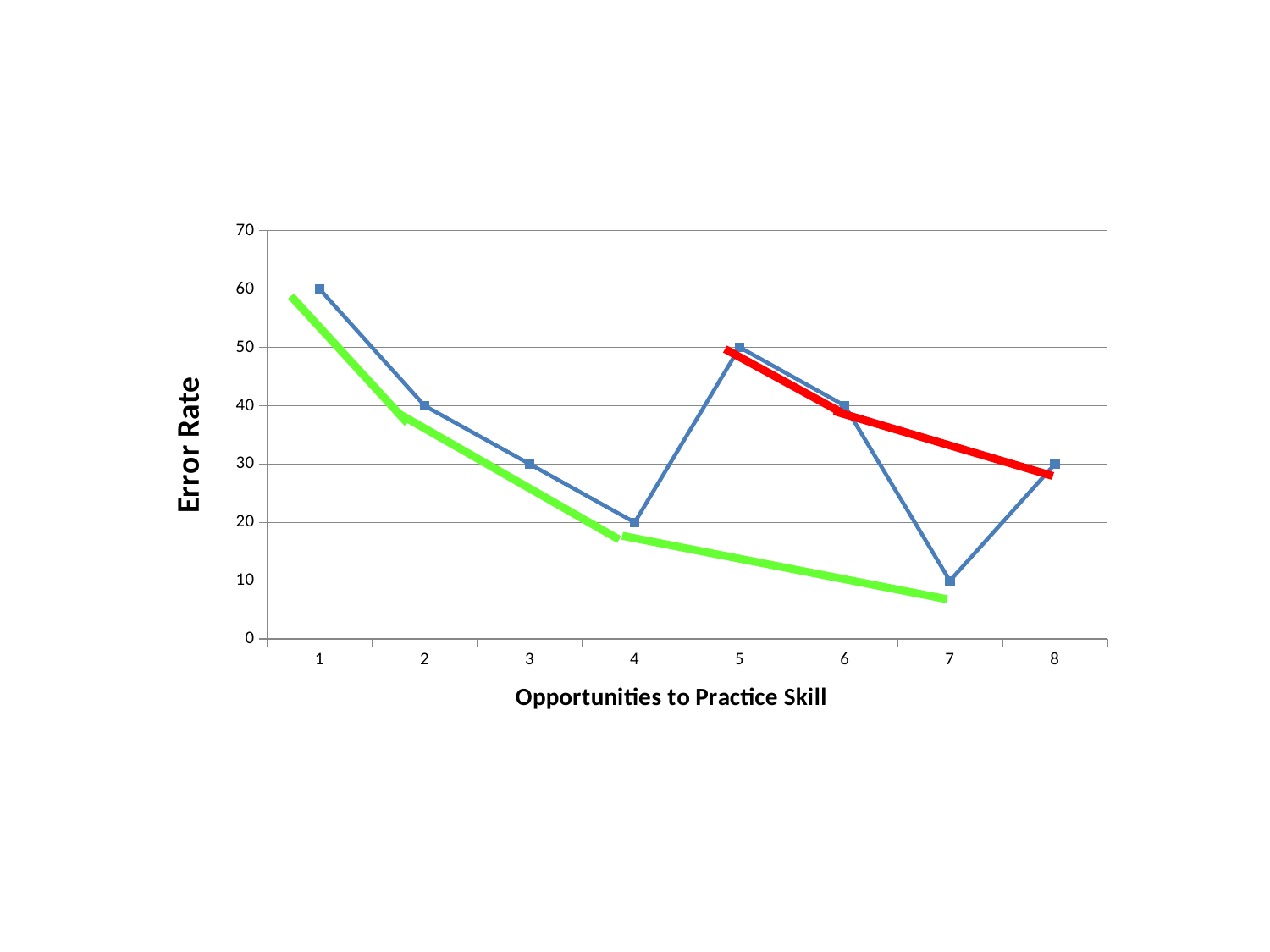
Does the error rate rise or fall from opportunity 1 to opportunity 4? fall What is the label of the y axis? Error Rate Which has a higher error rate, opportunity 5 or opportunity 8? opportunity 5 How many opportunities to practice skill are plotted on the x axis? 8 At which opportunity is the error rate lowest? 7 What kind of chart is shown on the slide? line chart What is the difference in error rate between opportunity 1 and opportunity 4? 40 At which opportunity is the error rate highest? 1 What is the error rate at opportunity 4? 20 What is the error rate at opportunity 7? 10 What is the error rate at opportunity 1? 60 What is the error rate at opportunity 5? 50